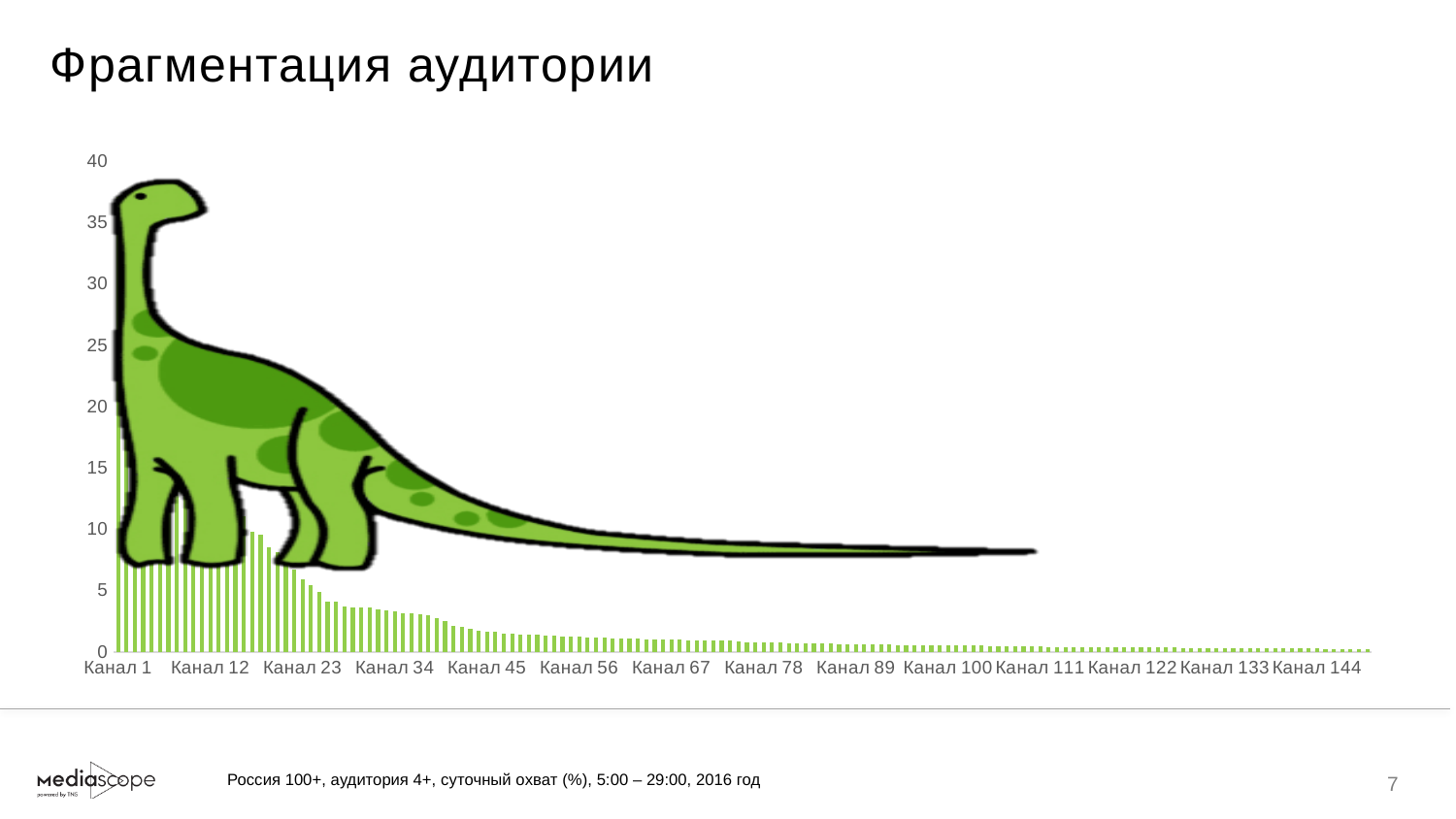
What is the title of the slide containing the chart? Фрагментация аудитории Do the values rise or fall moving from Канал 1 toward Канал 144 along the x axis? fall Which has the larger value, Канал 34 or Канал 100? Канал 34 Which has the larger value, Канал 23 or Канал 45? Канал 23 What kind of chart is shown on the slide? bar chart Is the value for Канал 144 greater or less than 5? less Is the value for Канал 45 greater or less than 5? less Is the value for Канал 78 greater or less than 10? less What is the highest value shown on the chart's y axis? 40